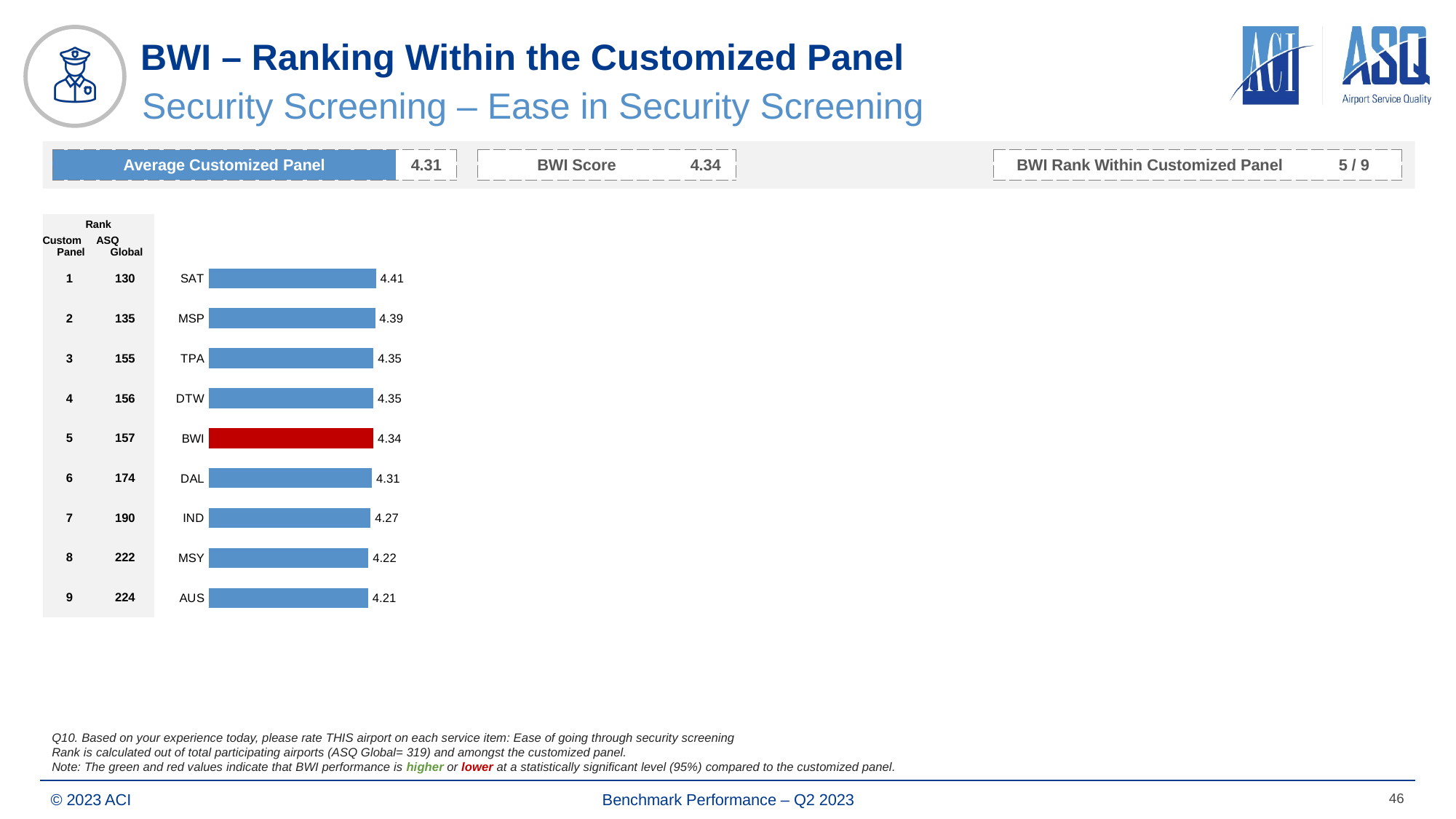
What is the difference between the values for BWI and DAL? 0.03 What is the value for SAT in the bar chart? 4.41 What is the value for IND in the bar chart? 4.27 What is the value for BWI in the bar chart? 4.34 What kind of chart is shown on the slide? Bar chart Which airport has the lowest value in the bar chart? AUS Which has a larger value, MSP or MSY? MSP Which airport has the highest value in the bar chart? SAT How many airports are shown in the bar chart? 9 Which bar in the chart is coloured red? BWI What is the value for AUS in the bar chart? 4.21 What is the difference between the values for SAT and AUS? 0.20